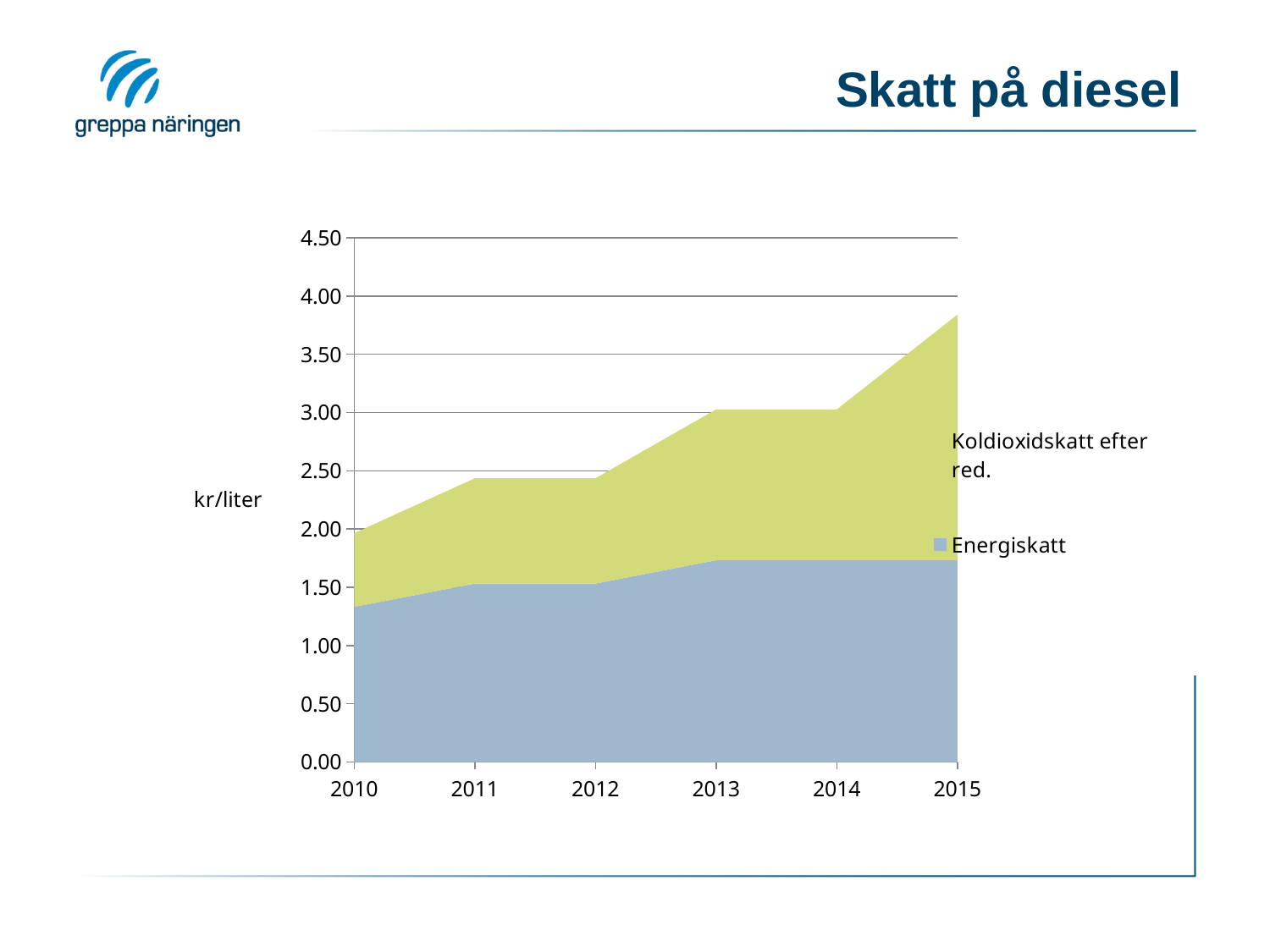
What is the title of the slide's chart? Skatt på diesel Is the total tax on diesel in 2015 greater or less than 3.50? greater Which is larger, the total tax on diesel in 2015 or in 2010? 2015 In which year is the total tax on diesel highest? 2015 Is the value for Energiskatt in 2015 greater or less than 1.50? greater What unit is shown on the y axis label? kr/liter What kind of chart is shown on the slide? Area chart Is the value for Energiskatt in 2010 greater or less than 1.50? less In which year is the total tax on diesel lowest? 2010 How many years are shown on the x axis? 6 Does the total tax on diesel rise or fall from 2010 to 2015? Rise How many series does the legend list? 2